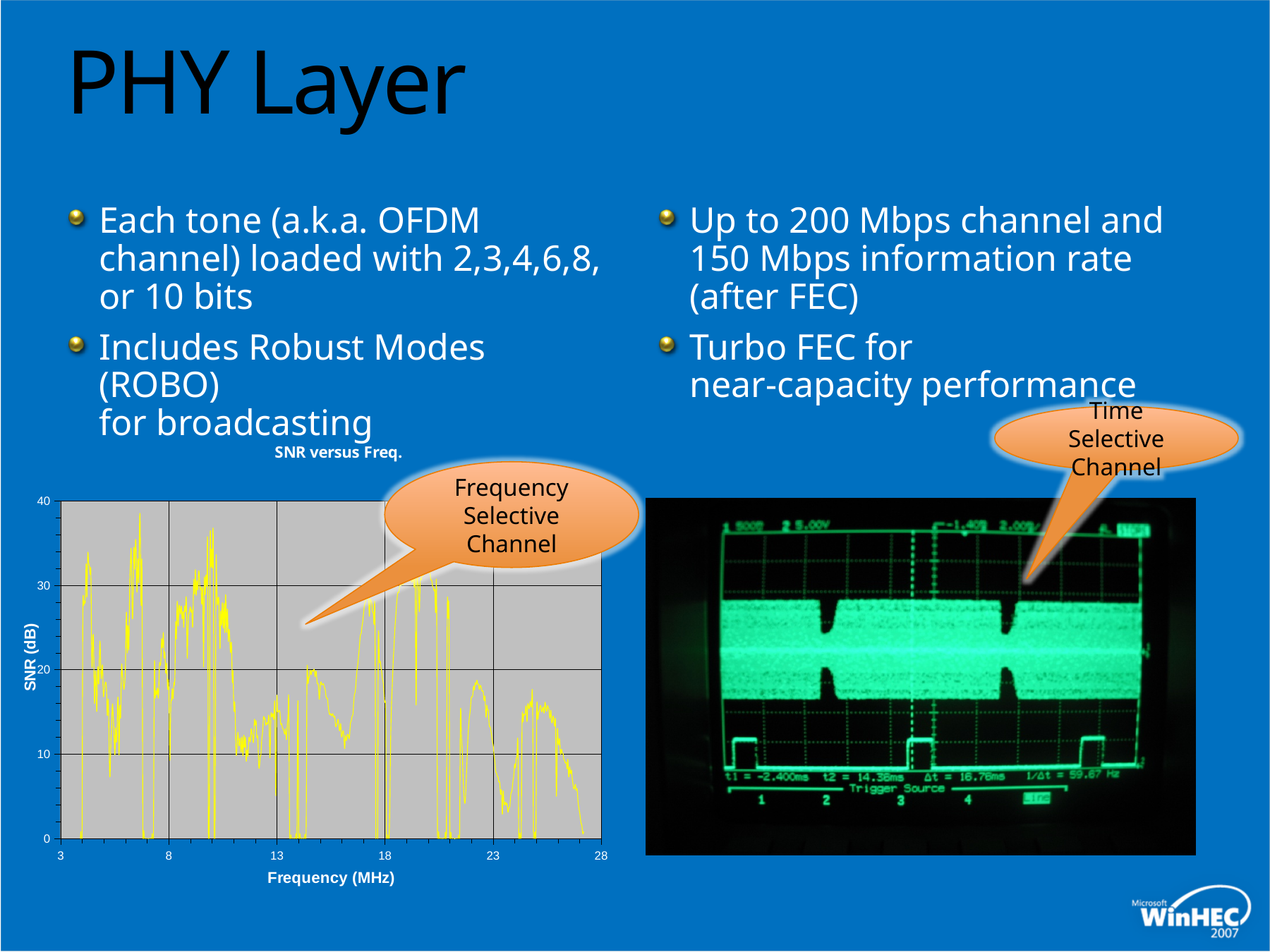
In the "SNR versus Freq." chart, what is the highest value shown on the y axis? 40 What kind of chart is the "SNR versus Freq." chart on the left of the slide? line chart In the "SNR versus Freq." chart, what is the highest frequency shown on the x axis? 28 In the "SNR versus Freq." chart, what is the label of the x axis? Frequency (MHz) In the "SNR versus Freq." chart, does any plotted SNR value exceed 40 dB? no In the "SNR versus Freq." chart, what is the lowest frequency shown on the x axis? 3 What is the title of the chart on the left of the slide? SNR versus Freq. In the "SNR versus Freq." chart, how many tick labels are shown on the x axis? 6 In the "SNR versus Freq." chart, is the SNR at 13 MHz greater or less than 20 dB? less In the "SNR versus Freq." chart, how many tick labels are shown on the y axis? 5 In the "SNR versus Freq." chart, does the highest SNR value plotted exceed 30 dB? yes